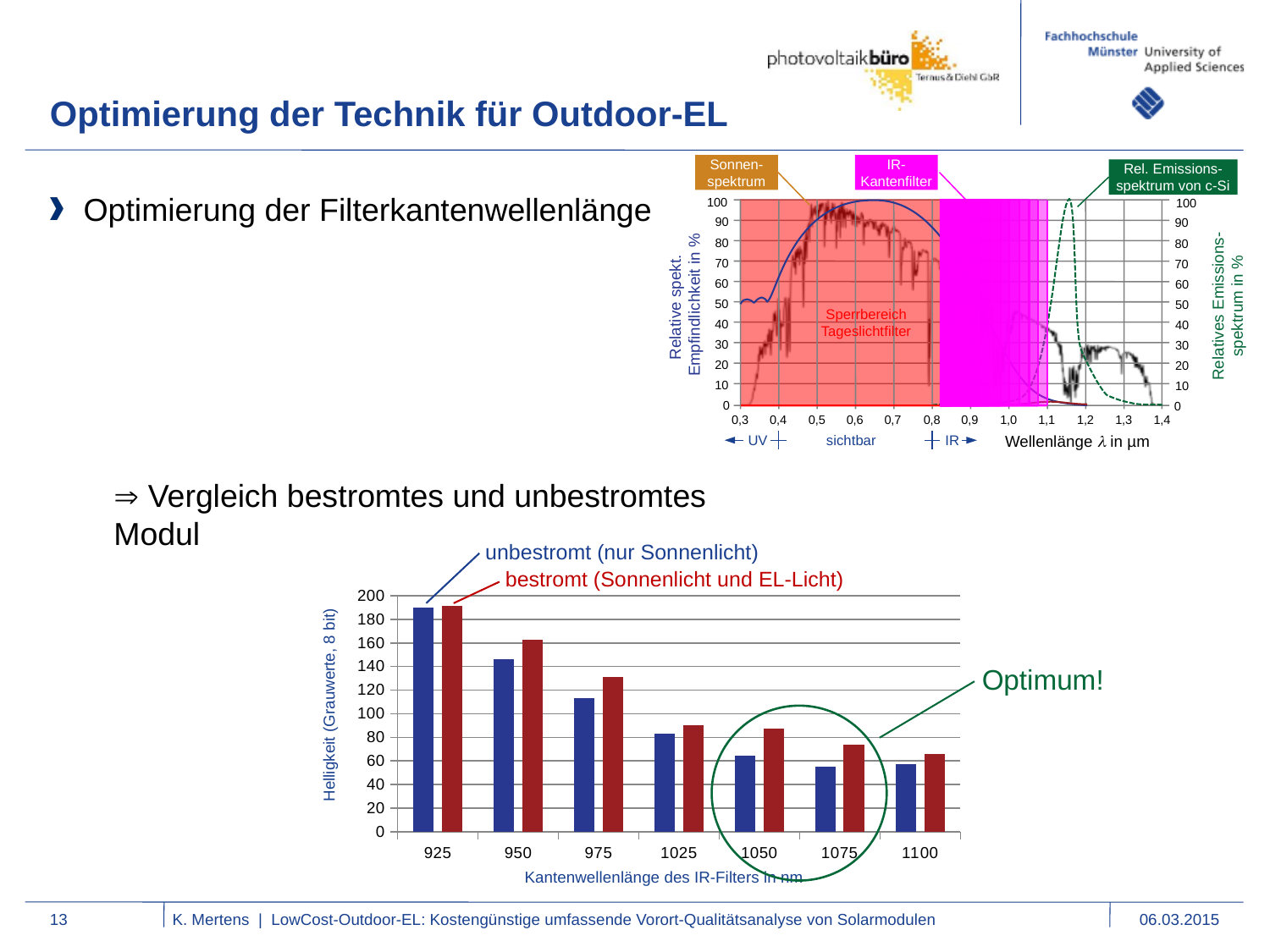
In the bottom chart, what kind of chart is used to show the Helligkeit values? bar chart In the bottom chart, is the unbestromt value at 950 greater or less than 140? greater In the bottom chart, how many series are shown? 2 In the bottom chart, at which Kantenwellenlänge is the bestromt (red) value lowest? 1100 In the top-right chart, what is the label of the x axis? Wellenlänge λ in µm In the bottom chart, is the unbestromt value at 1075 greater or less than 60? less In the bottom chart, is the unbestromt value at 1025 greater or less than 100? less In the bottom chart, how many Kantenwellenlänge categories are shown on the x axis? 7 In the bottom chart, at 1050 nm, which is larger: the unbestromt value or the bestromt value? bestromt In the bottom chart, do the bestromt values generally rise or fall as the Kantenwellenlänge increases from 925 to 1100? fall In the bottom chart, at which Kantenwellenlänge is the bestromt (red) value highest? 925